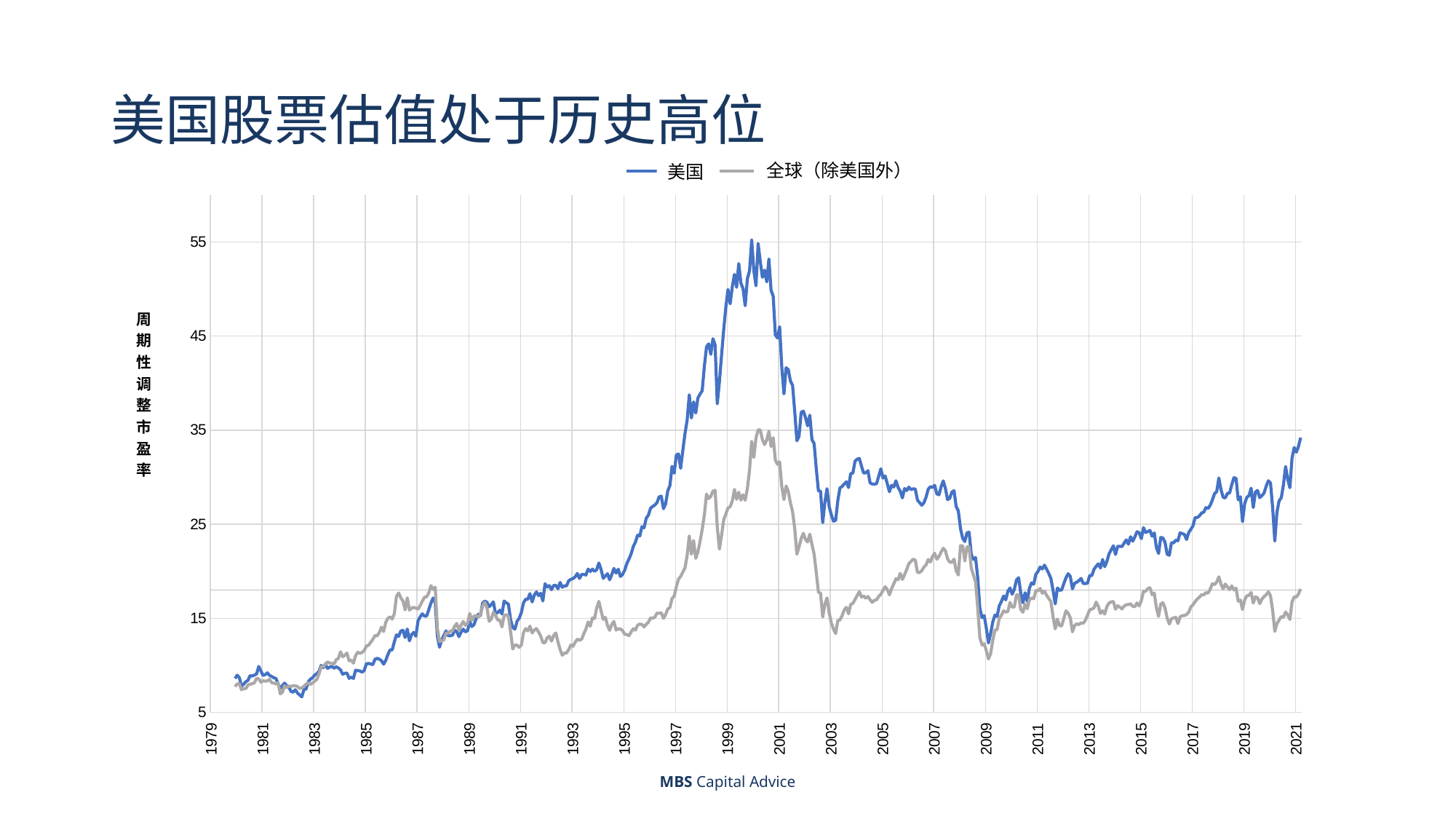
What is the title of the chart on the slide? 美国股票估值处于历史高位 Is the value of the 全球（除美国外） series in 2021 greater or less than 25? less Is the peak value of the 全球（除美国外） series around 2000 greater or less than 25? greater Which series has the higher value in 2021, 美国 or 全球（除美国外）? 美国 What kind of chart is shown on the slide? line chart Is the value of the 美国 series at the end of the chart in 2021 greater or less than 25? greater How many series does the legend list? 2 Which series has the higher value around 1986, 美国 or 全球（除美国外）? 全球（除美国外） What is the label of the vertical axis? 周期性调整市盈率 Does the 美国 series rise or fall between 2009 and 2021? rise